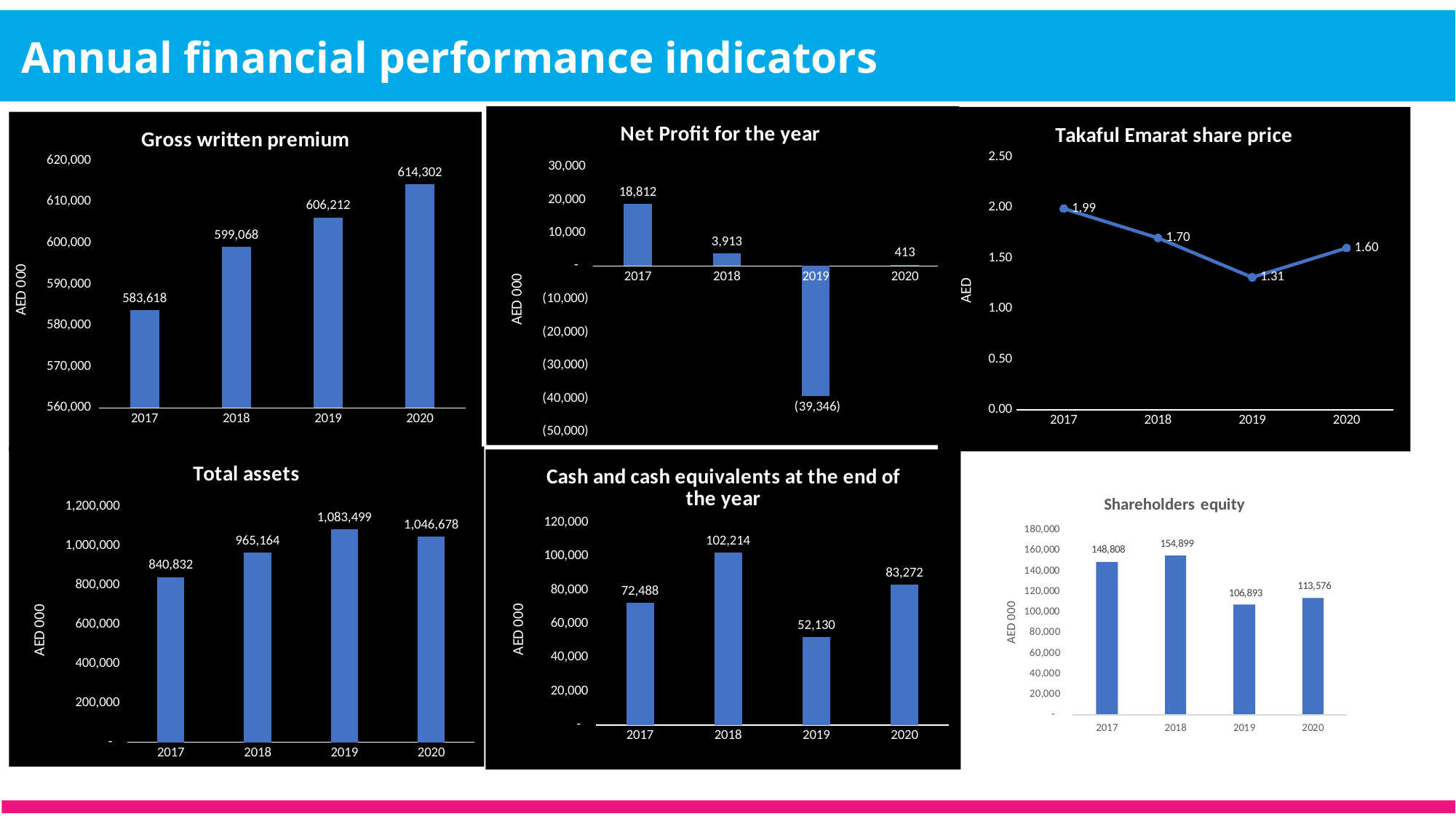
In the 'Total assets' chart, what is the difference between the 2019 and 2020 values? 36,821 In the 'Cash and cash equivalents at the end of the year' chart, which is larger, the value for 2017 or 2020? 2020 In the 'Takaful Emarat share price' chart, what is the share price for 2019? 1.31 In the 'Cash and cash equivalents at the end of the year' chart, what is the value for 2019? 52,130 What kind of chart is the 'Takaful Emarat share price' chart? line chart In the 'Shareholders equity' chart, what is the value for 2018? 154,899 In the 'Gross written premium' chart, what is the value for 2020? 614,302 In the 'Net Profit for the year' chart, what is the value for 2018? 3,913 In the 'Gross written premium' chart, do the values rise or fall from 2017 to 2020? rise In the 'Net Profit for the year' chart, which year has the lowest value? 2019 In the 'Shareholders equity' chart, how many years are shown? 4 In the 'Total assets' chart, which year has the highest value? 2019